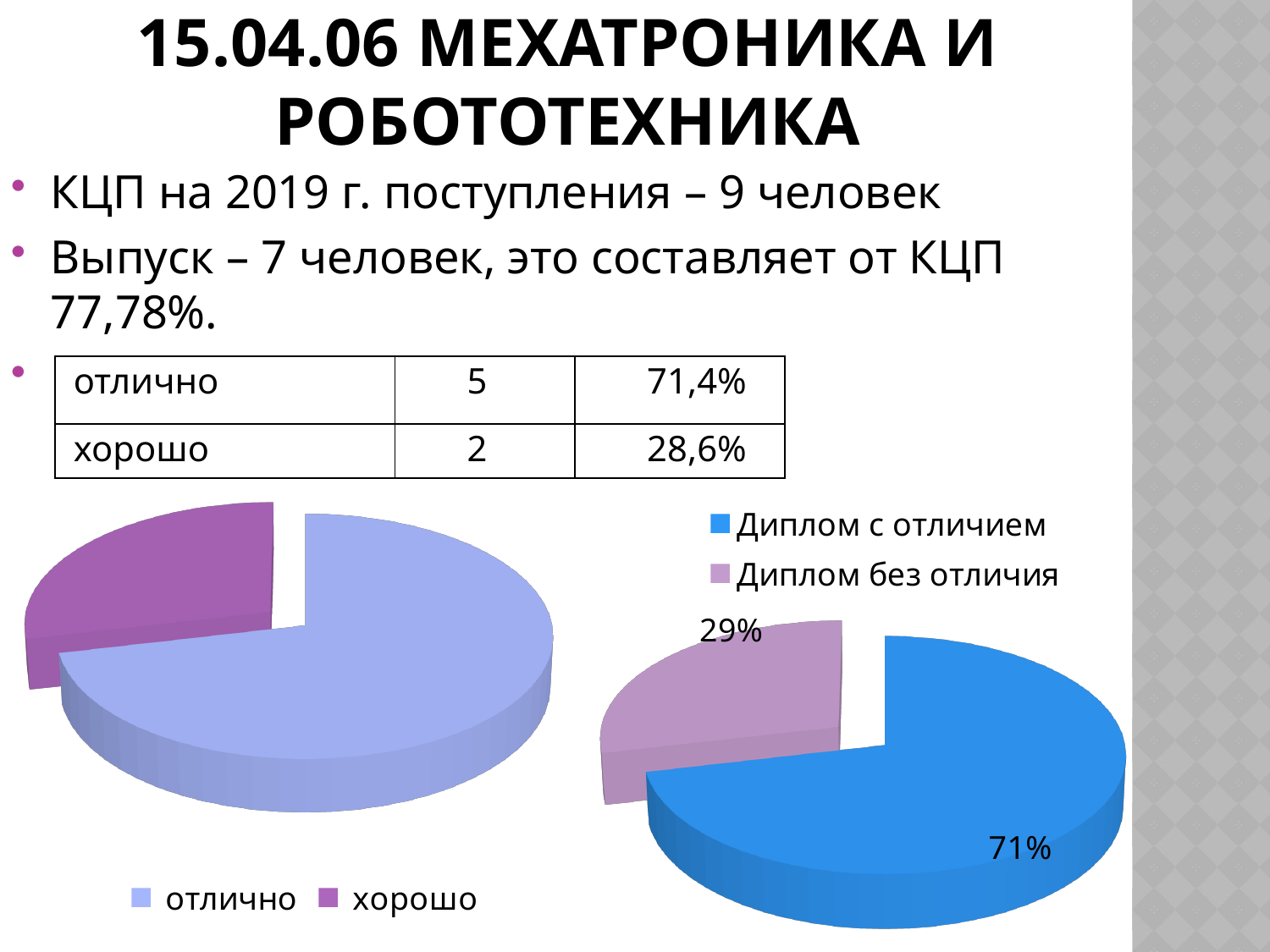
In the right chart, which category has the smallest slice? Диплом без отличия In the right chart, which category has the largest slice? Диплом с отличием In the left chart, which category has the smallest slice? хорошо In the right chart, what share is labelled for 'Диплом без отличия'? 29% What kind of chart is the left chart with the legend 'отлично' and 'хорошо'? pie chart What kind of chart is the right chart with the legend 'Диплом с отличием' and 'Диплом без отличия'? pie chart In the left chart, how many categories does the legend list? 2 In the right chart, what share is labelled for 'Диплом с отличием'? 71% In the right chart, how many slices does the pie have? 2 In the right chart, what colour is the slice for 'Диплом с отличием'? blue In the left chart, which category has the larger slice, 'отлично' or 'хорошо'? отлично In the right chart, what is the difference in percentage points between 'Диплом с отличием' and 'Диплом без отличия'? 42